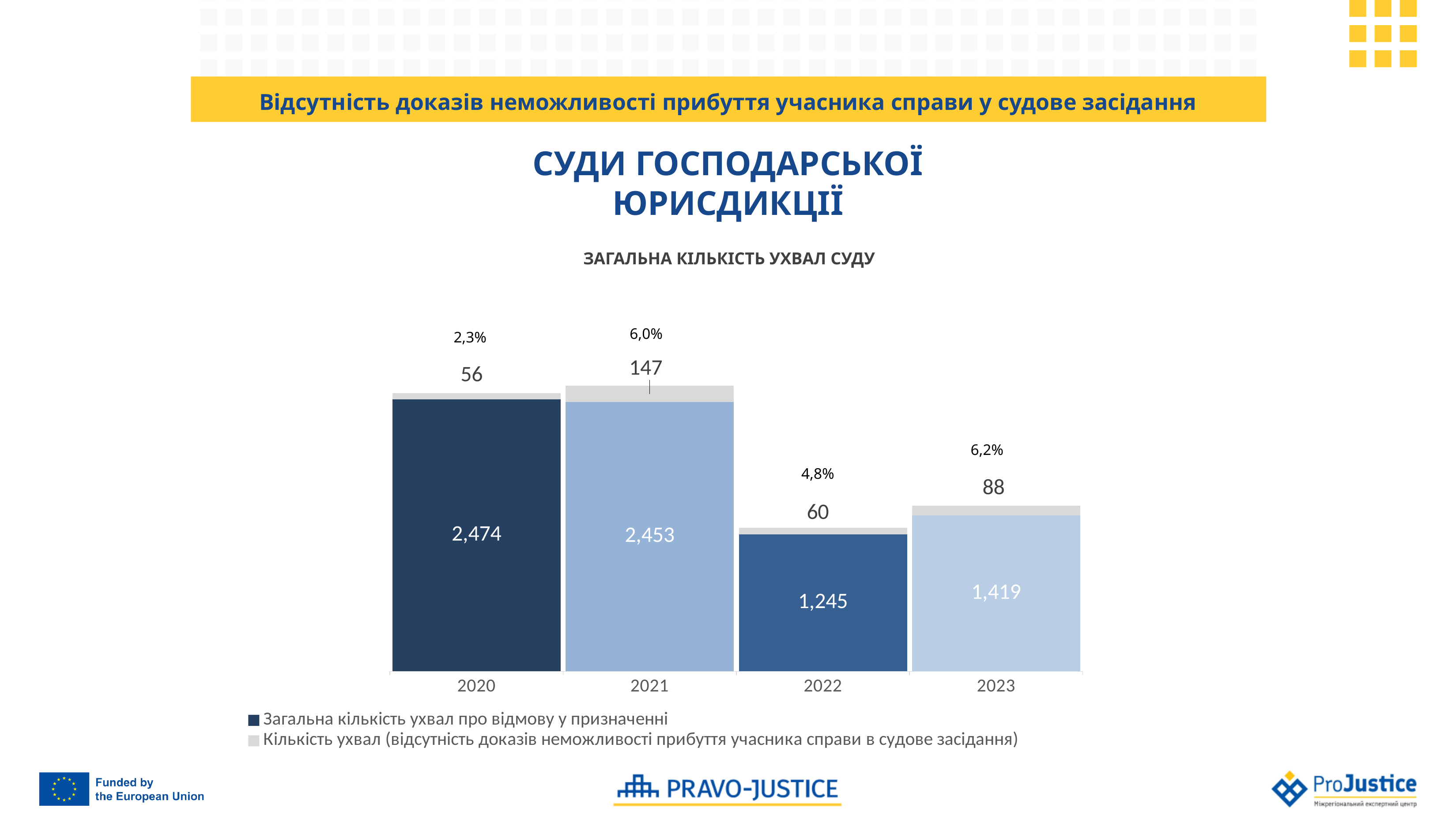
Which is larger: the light grey series value for 2022 or for 2023? 2023 How many series does the legend list? 2 Which year has the highest value for the light grey series (Кількість ухвал)? 2021 What is the difference between the dark series values for 2020 and 2021? 21 How many years are shown on the x axis? 4 What kind of chart is shown on the slide? Stacked bar chart What is the total of the stacked bar for 2023? 1,507 What percentage is shown above the bar for 2023? 6,2% Which year has the lowest value for the dark series (Загальна кількість ухвал про відмову у призначенні)? 2022 What is the value of the light grey series (Кількість ухвал) for 2021? 147 What is the value of the dark series for 2022? 1,245 What is the value of the dark series (Загальна кількість ухвал про відмову у призначенні) for 2020? 2,474